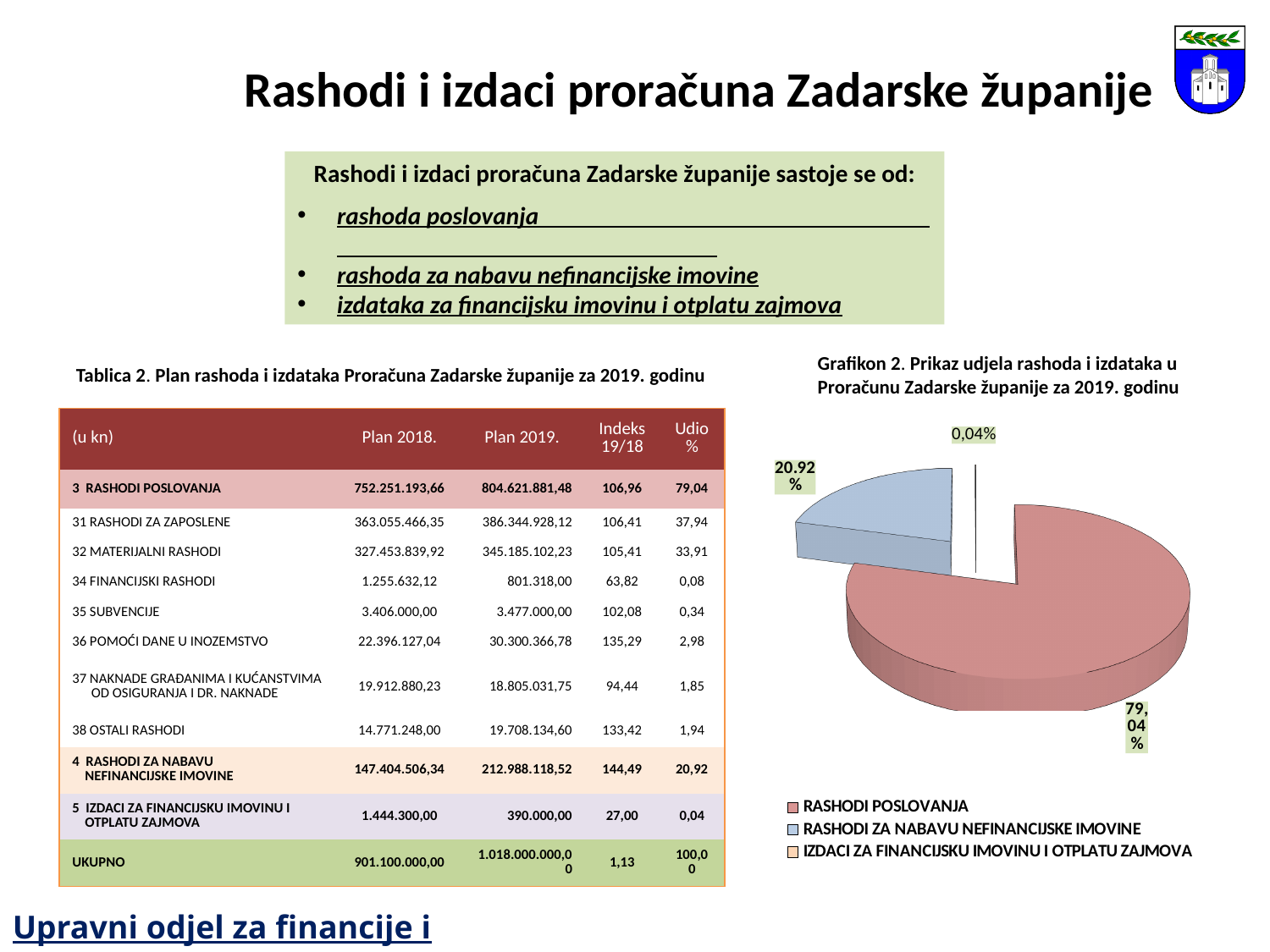
What is the difference in percentage points between the RASHODI POSLOVANJA slice and the RASHODI ZA NABAVU NEFINANCIJSKE IMOVINE slice? 58,12% What share of the pie chart does RASHODI ZA NABAVU NEFINANCIJSKE IMOVINE represent? 20,92% What share of the pie chart does RASHODI POSLOVANJA represent? 79,04% What type of chart is shown on the slide? Pie chart Which is larger in the pie chart: RASHODI POSLOVANJA or RASHODI ZA NABAVU NEFINANCIJSKE IMOVINE? RASHODI POSLOVANJA What is the title of the pie chart? Grafikon 2. Prikaz udjela rashoda i izdataka u Proračunu Zadarske županije za 2019. godinu Which legend entry is shown in the pink/red colour in the pie chart? RASHODI POSLOVANJA Which category has the largest slice in the pie chart? RASHODI POSLOVANJA What share of the pie chart does IZDACI ZA FINANCIJSKU IMOVINU I OTPLATU ZAJMOVA represent? 0,04% How many entries does the pie chart legend list? 3 How many slices does the pie chart have? 3 Which category has the smallest slice in the pie chart? IZDACI ZA FINANCIJSKU IMOVINU I OTPLATU ZAJMOVA